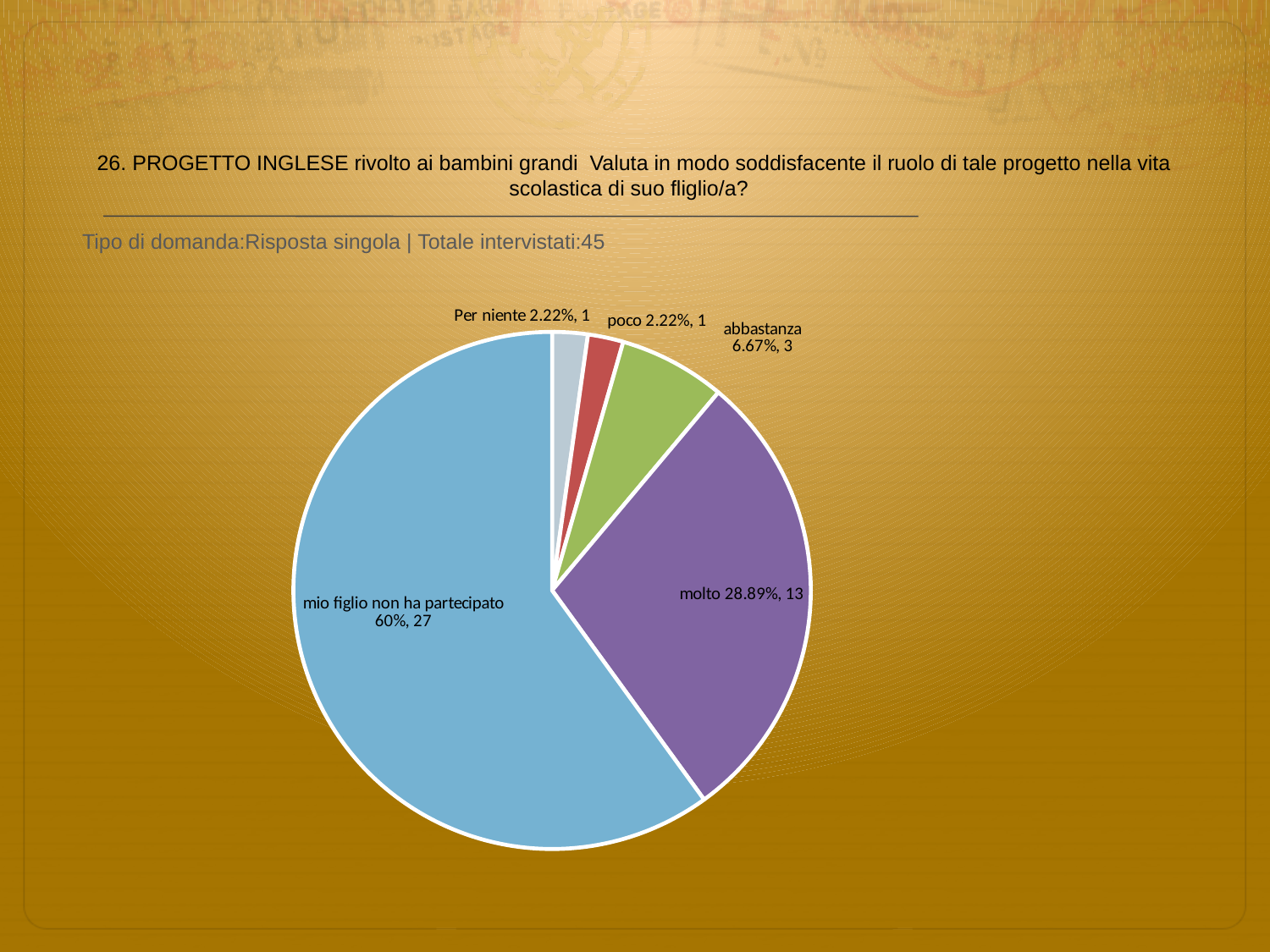
What percentage share does the 'molto' slice have? 28.89% What kind of chart is shown on the slide? pie chart What percentage share does the slice 'mio figlio non ha partecipato' have? 60% How many respondents chose 'abbastanza'? 3 How many respondents chose 'molto'? 13 How many slices does the pie chart have? 5 What is the difference between the number of respondents for 'mio figlio non ha partecipato' and for 'molto'? 14 What is the total number of respondents shown on the slide? 45 What percentage share does the 'poco' slice have? 2.22% Which category has the largest slice? mio figlio non ha partecipato Which is larger, the count for 'molto' or the count for 'abbastanza'? molto What colour is the 'molto' slice? purple